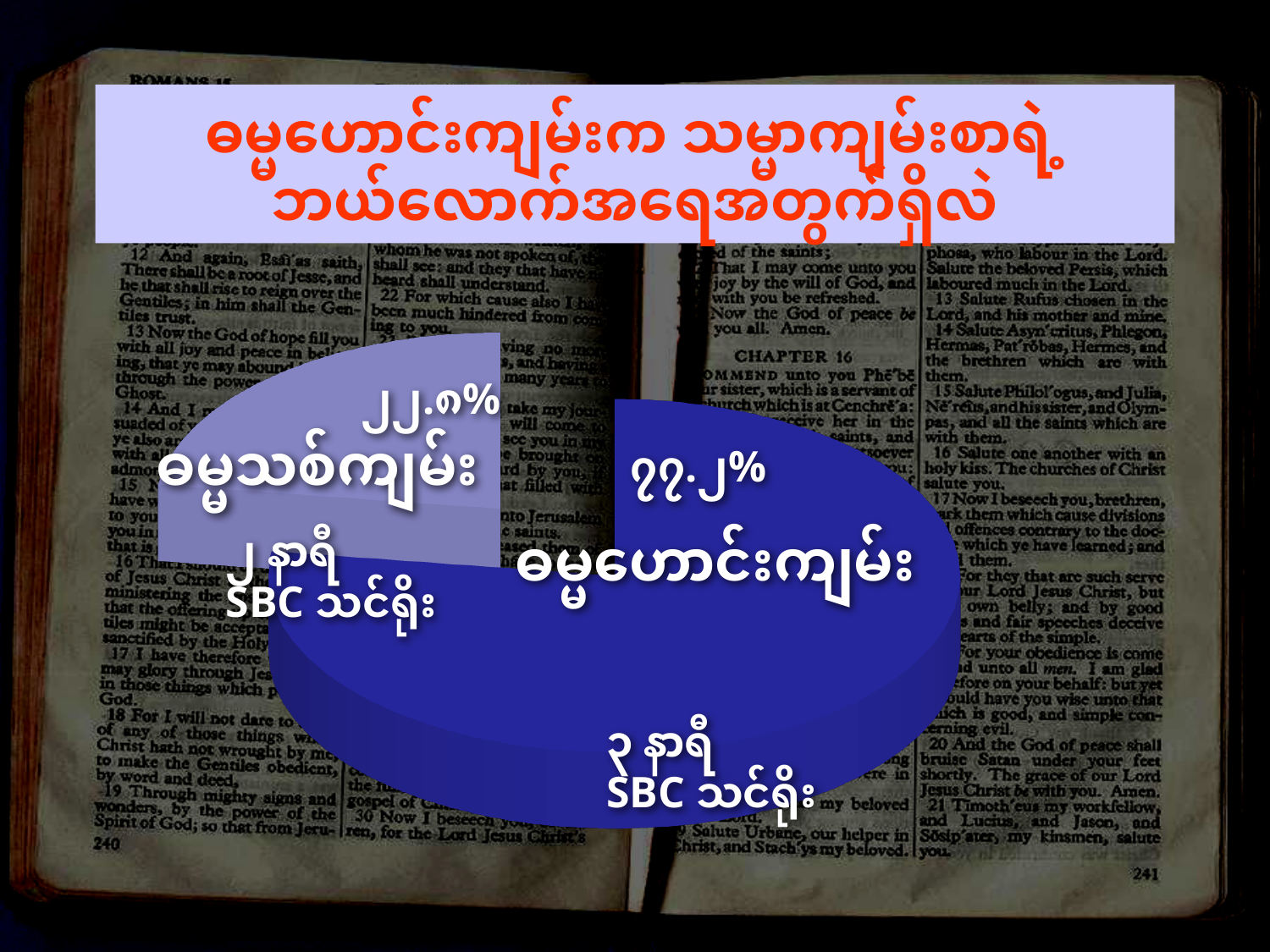
What colour is the ဓမ္မဟောင်းကျမ်း slice of the pie chart? dark blue What share of the pie does the ဓမ္မဟောင်းကျမ်း slice represent? ၇၇.၂% What kind of chart is shown on the slide? pie chart Which slice of the pie chart is the largest? ဓမ္မဟောင်းကျမ်း How many slices does the pie chart have? 2 Which slice of the pie chart is the smallest? ဓမ္မသစ်ကျမ်း What percentage is shown for the ဓမ္မသစ်ကျမ်း (New Testament) slice? ၂၂.၈% Which is larger, the ဓမ္မဟောင်းကျမ်း slice or the ဓမ္မသစ်ကျမ်း slice? ဓမ္မဟောင်းကျမ်း How many hours of SBC သင်ရိုး are labelled on the ဓမ္မသစ်ကျမ်း slice? ၂ နာရီ What is the difference in percentage points between the ဓမ္မဟောင်းကျမ်း slice and the ဓမ္မသစ်ကျမ်း slice? ၅၄.၄ How many hours of SBC သင်ရိုး are labelled on the ဓမ္မဟောင်းကျမ်း slice? ၃ နာရီ What percentage is shown for the ဓမ္မဟောင်းကျမ်း (Old Testament) slice? ၇၇.၂%